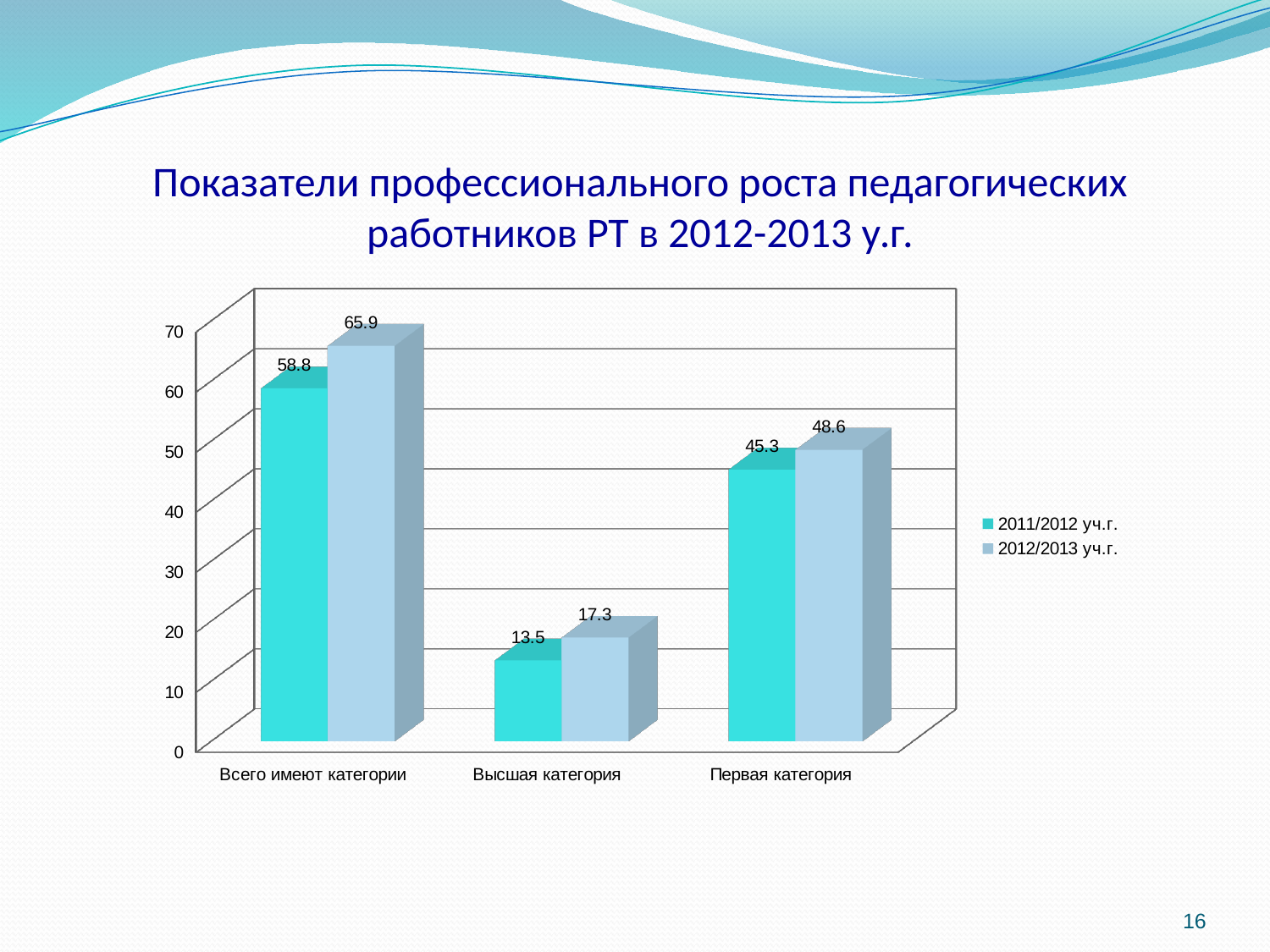
What is the difference between the 2012/2013 уч.г. and 2011/2012 уч.г. values for Первая категория? 3.3 How many series does the legend list? 2 Which category has the lowest value in the 2011/2012 уч.г. series? Высшая категория What is the difference between the 2012/2013 уч.г. and 2011/2012 уч.г. values for Всего имеют категории? 7.1 Which category has the highest value in the 2012/2013 уч.г. series? Всего имеют категории How many categories are shown on the x axis? 3 What kind of chart is shown on the slide? bar chart What is the value for Высшая категория in the 2012/2013 уч.г. series? 17.3 What is the value for Первая категория in the 2011/2012 уч.г. series? 45.3 Is the 2012/2013 уч.г. value for Первая категория greater or less than 40? greater What is the value for Всего имеют категории in the 2011/2012 уч.г. series? 58.8 Which is larger for Высшая категория: the 2011/2012 уч.г. value or the 2012/2013 уч.г. value? 2012/2013 уч.г.